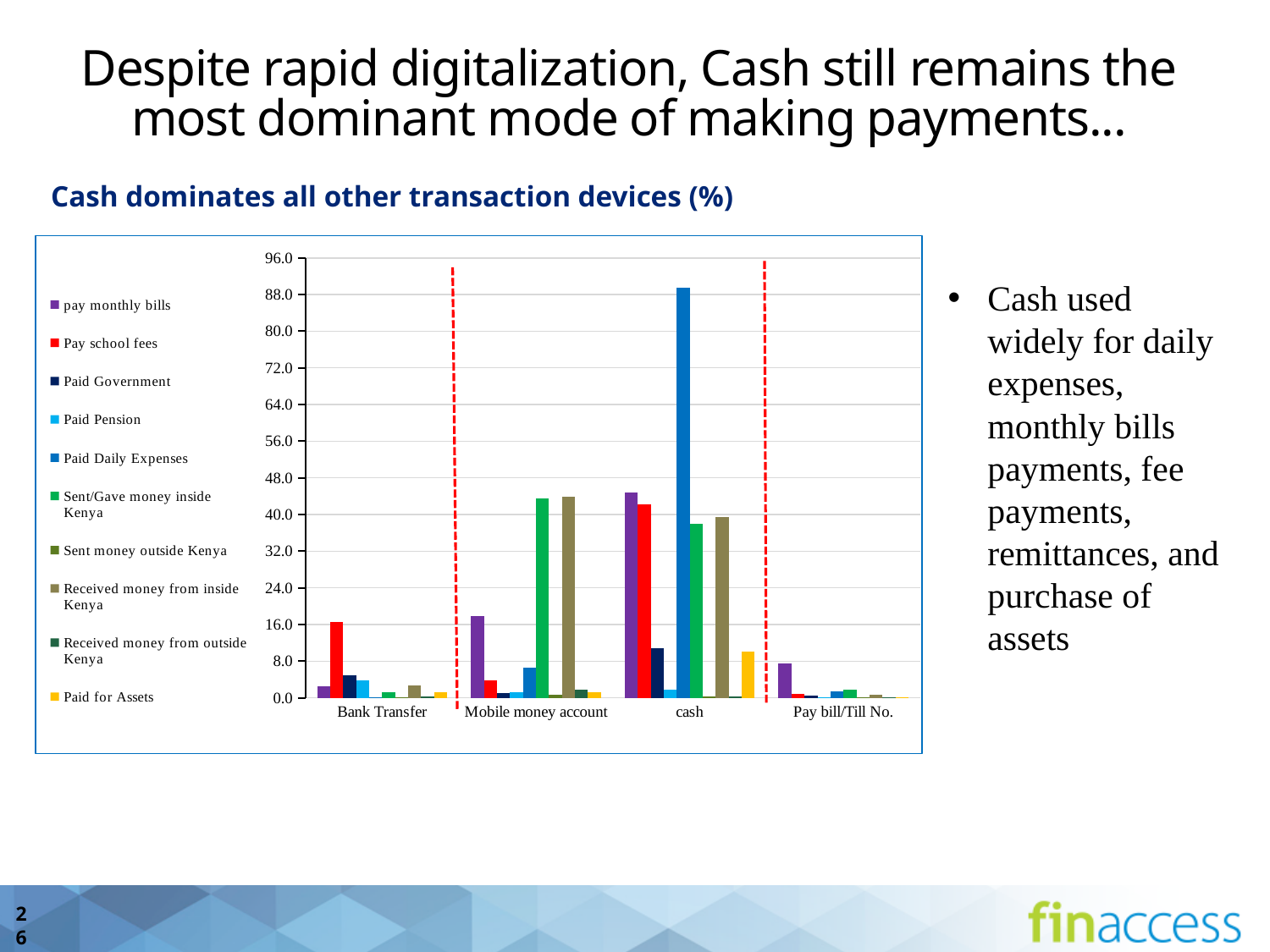
What is the title of the chart? Cash dominates all other transaction devices (%) Within the cash category, which series has the tallest bar? Paid Daily Expenses How many payment-mode categories are shown on the x axis of the chart? 4 Is the value for Sent/Gave money inside Kenya under Mobile money account greater or less than 40? greater What kind of chart is shown on the slide? bar chart Which is larger: Pay school fees under Bank Transfer or Pay school fees under cash? cash Is the value for Paid Daily Expenses under cash greater or less than 80? greater How many series does the chart's legend list? 10 Is the value for Pay school fees under Bank Transfer greater or less than 8? greater Which payment mode has the highest bar for pay monthly bills? cash Which payment mode has the highest bar for Paid Daily Expenses? cash